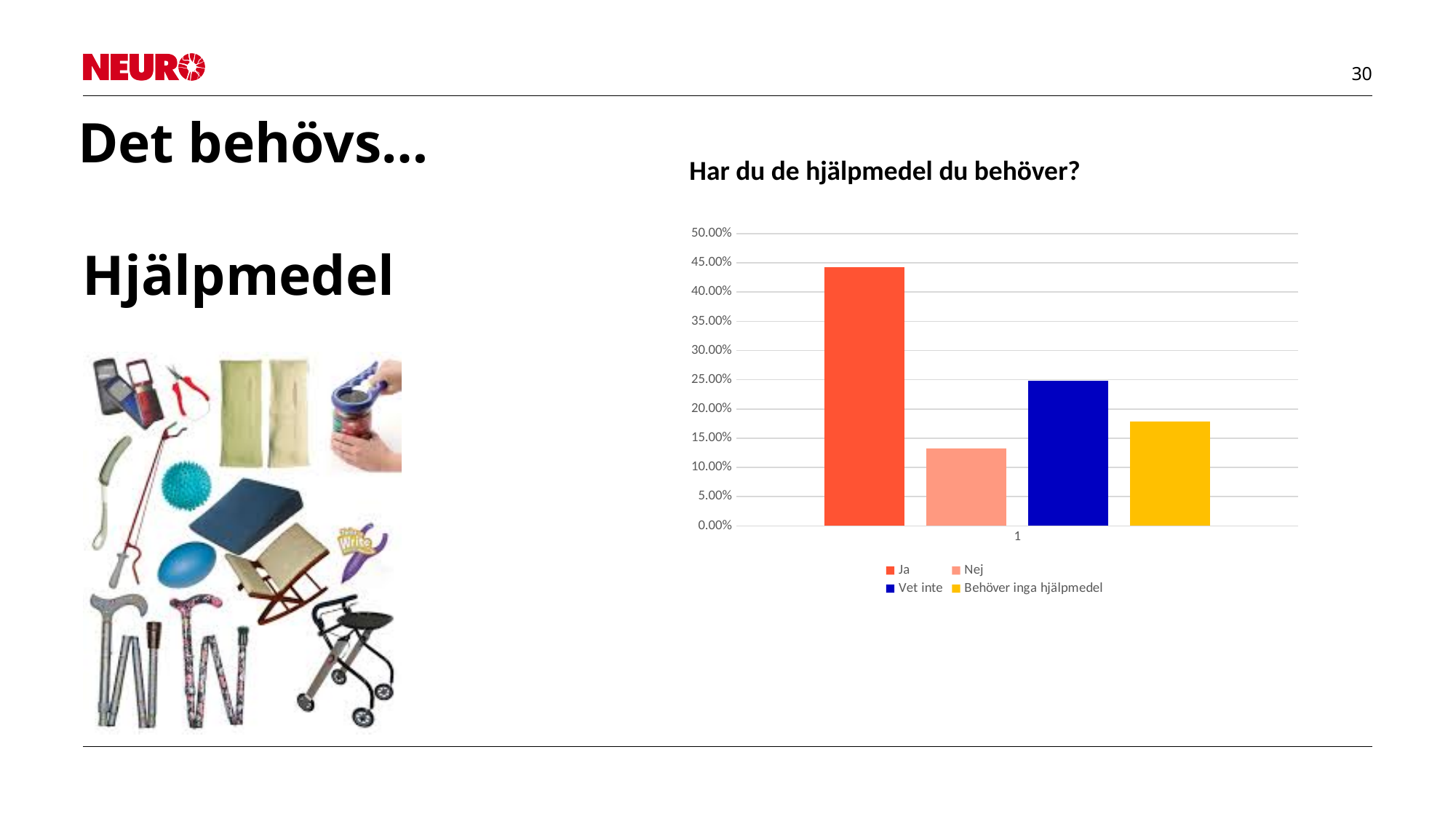
Which series has the lowest value in the chart? Nej What kind of chart is shown under the title "Har du de hjälpmedel du behöver?"? bar chart Which series has the highest value in the chart? Ja Which is larger, the value for Behöver inga hjälpmedel or the value for Ja? Ja Is the value for Ja greater or less than 40.00%? greater Is the value for Nej greater or less than 15.00%? less What is the title of the chart on the slide? Har du de hjälpmedel du behöver? Which is larger, the value for Vet inte or the value for Nej? Vet inte Is the value for Vet inte greater or less than 20.00%? greater What colour is the bar for Vet inte in the chart? blue How many series does the legend of the chart list? 4